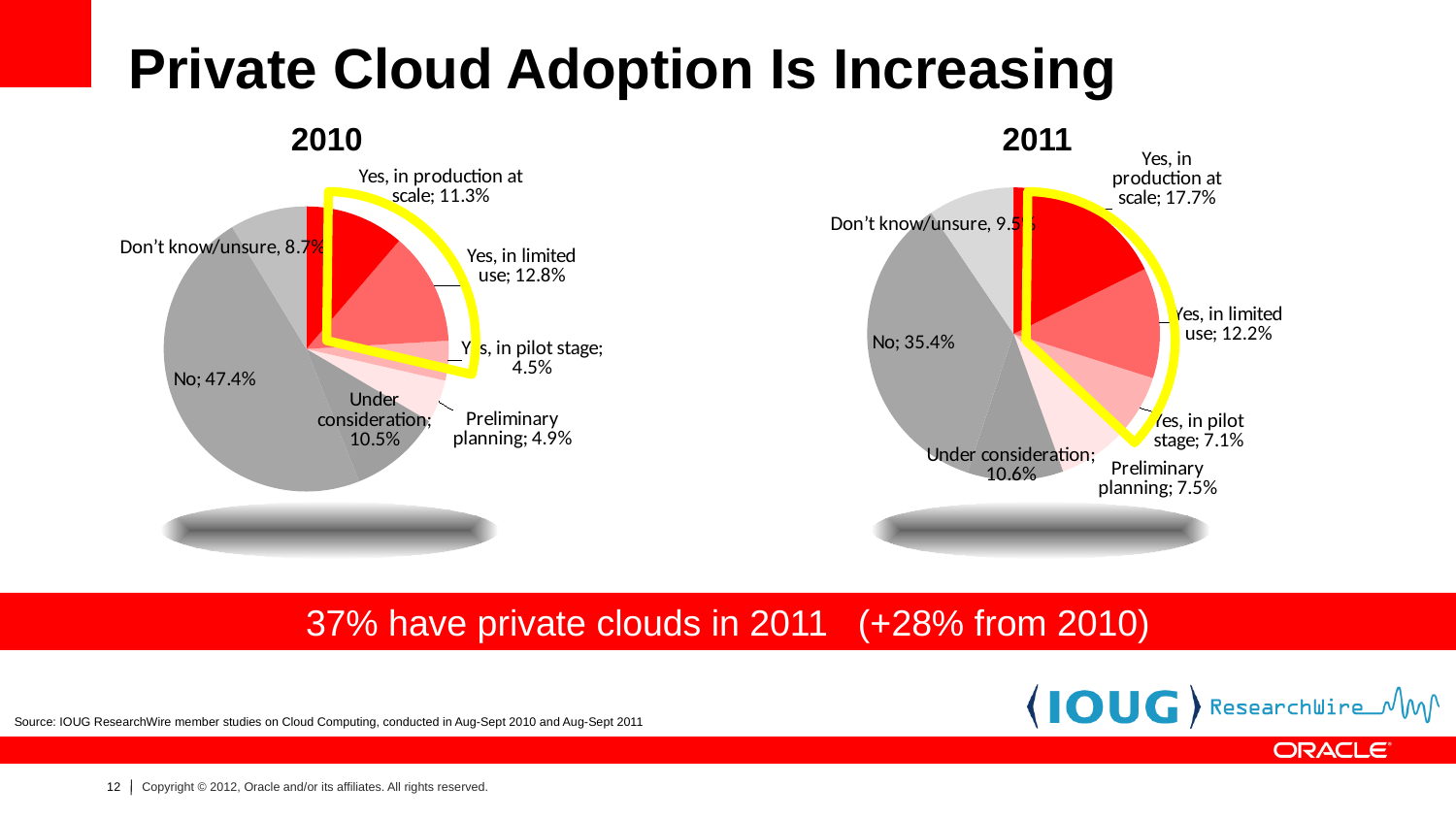
In the 2011 chart, what is the value for "Preliminary planning"? 7.5% In the 2010 chart, which category has the smallest slice? Yes, in pilot stage In the 2011 chart, what is the share for "Yes, in production at scale"? 17.7% In the 2011 chart, which category has the largest slice? No Which is larger in the 2011 chart: "Yes, in limited use" or "Yes, in pilot stage"? Yes, in limited use What is the difference between the "No" share in 2010 and the "No" share in 2011? 12.0% In the 2010 chart, what is the value for "Under consideration"? 10.5% What is the difference between "Yes, in production at scale" in 2011 and in 2010? 6.4% In the 2010 chart, what percentage of respondents answered "No"? 47.4% In the 2010 chart, which category has the largest slice? No What type of chart is used for the 2010 data? Pie chart How many categories does the 2011 pie chart show? 7